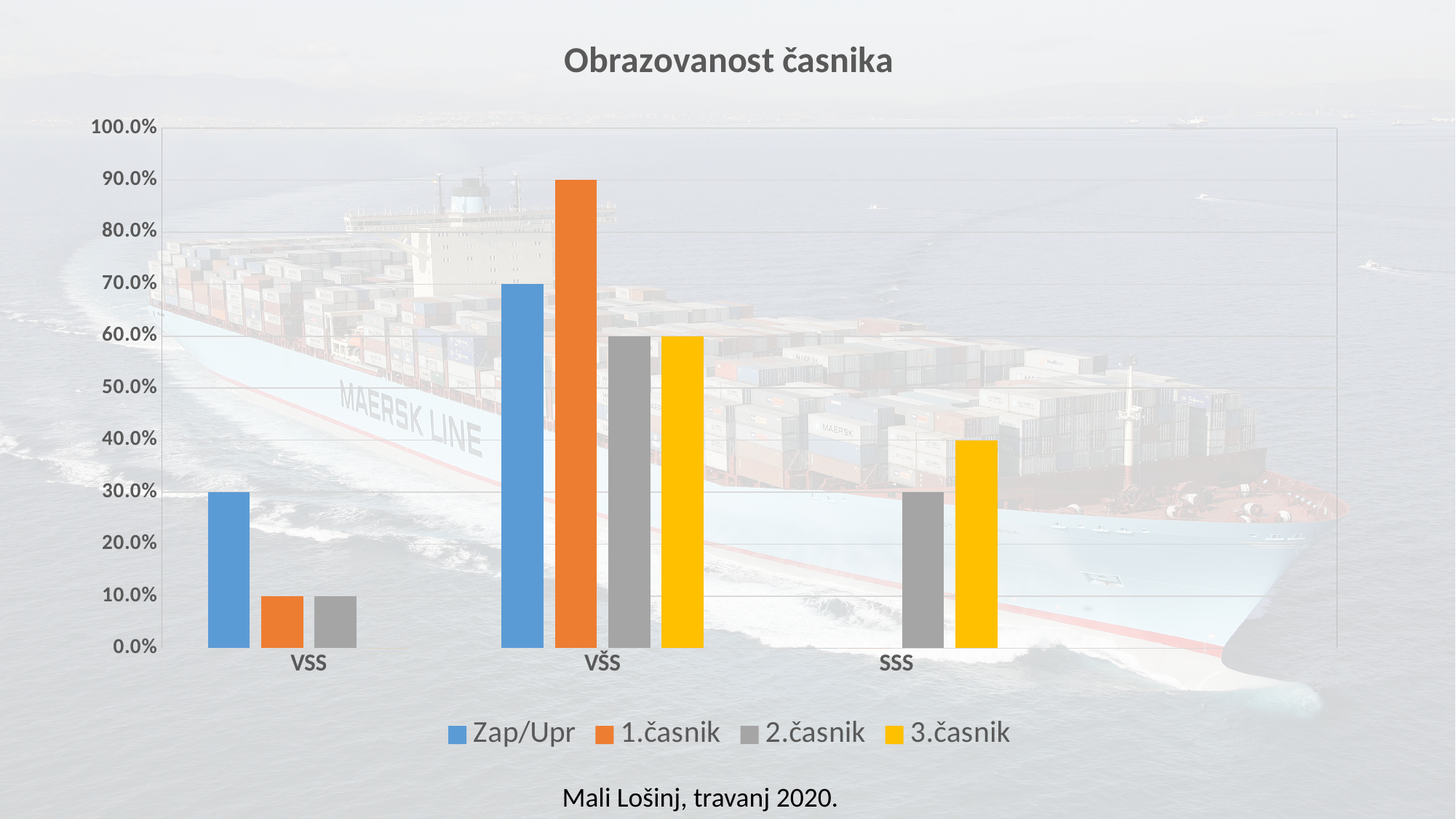
What is the value for Zap/Upr in the VSS category? 30.0% Which is larger in the SSS category: 2.časnik or 3.časnik? 3.časnik What kind of chart is shown on the slide? bar chart Which series has the highest value in the VŠS category? 1.časnik What is the title of the chart? Obrazovanost časnika What is the difference between the 1.časnik value and the Zap/Upr value in the VŠS category? 20.0% What is the value for 3.časnik in the SSS category? 40.0% How many categories are shown on the x axis? 3 How many series does the legend list? 4 What is the value for 1.časnik in the VŠS category? 90.0% Which colour represents the 3.časnik series in the legend? yellow Which category has the lowest value for 2.časnik? VSS